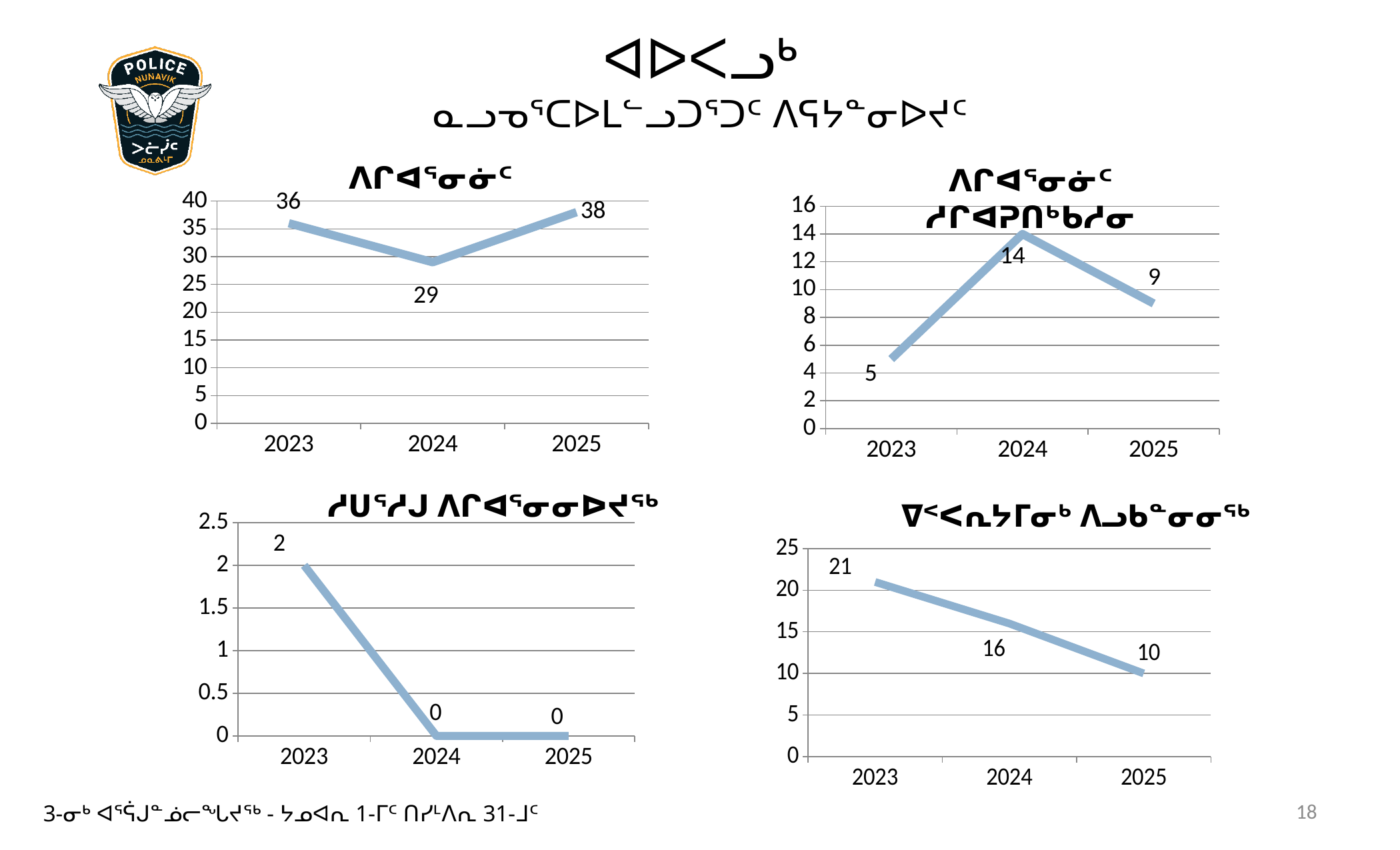
In the top-right chart, which year has the lowest value? 2023 In the top-left chart, what is the value for 2024? 29 In the bottom-right chart, do the values rise or fall from 2023 to 2025? fall In the top-right chart, what is the value for 2024? 14 In the top-left chart, what is the difference between the values for 2025 and 2024? 9 In the top-right chart, is the value for 2025 larger or smaller than the value for 2023? larger In the bottom-left chart, what is the value for 2023? 2 In the bottom-right chart, what is the difference between the values for 2023 and 2024? 5 In the bottom-right chart, what is the value for 2025? 10 How many charts are on the slide, and what type are they? 4 line charts In the top-left chart, which year has the highest value? 2025 In the bottom-left chart, what is the value for 2025? 0